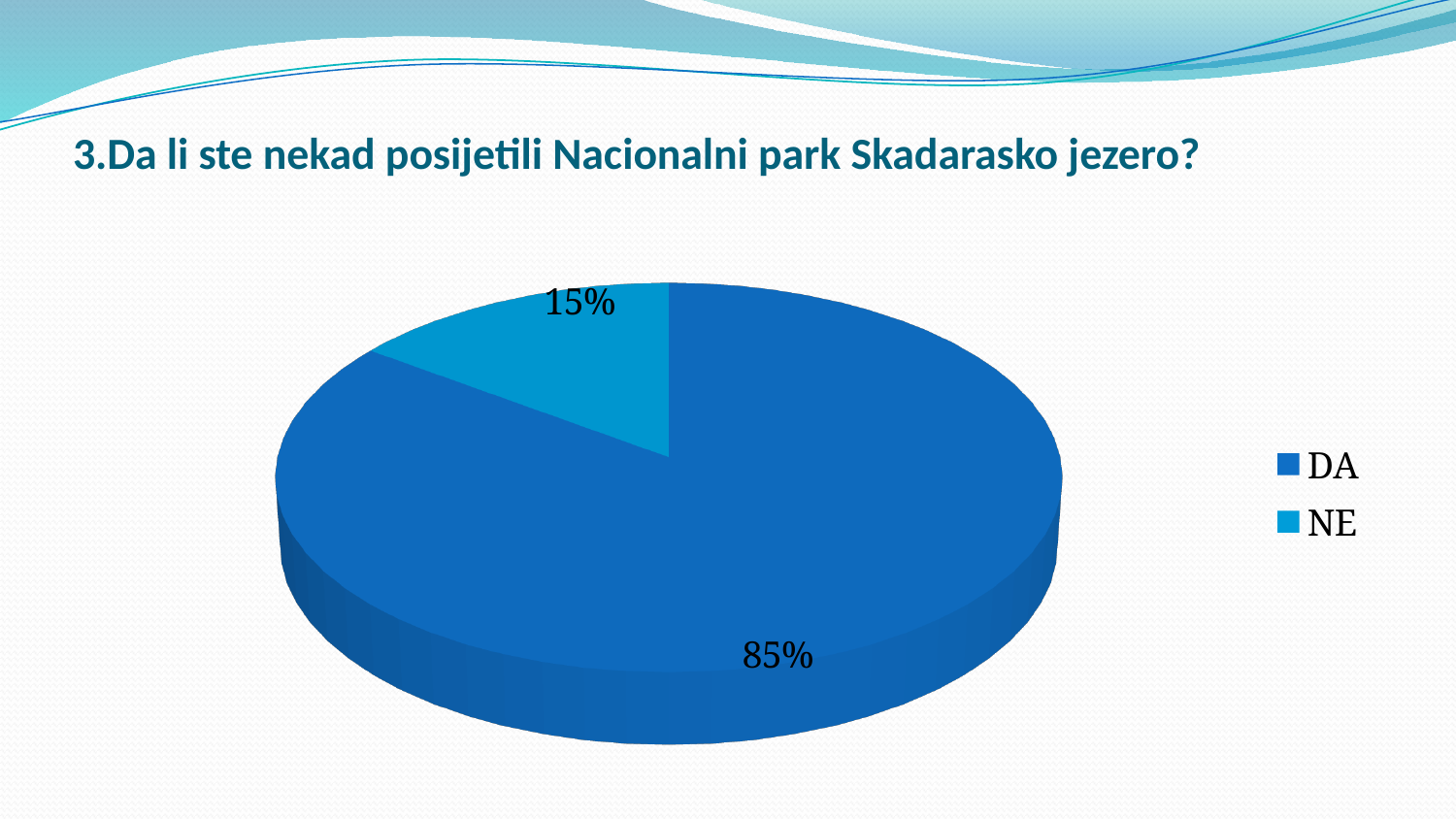
What share of the pie does NE represent? 15% Which category has the largest slice of the pie? DA What kind of chart is shown on the slide? pie chart What share of the pie does DA represent? 85% Which category has the smallest slice of the pie? NE What is the difference in percentage points between the DA and NE slices? 70 Which is larger, the DA slice or the NE slice? DA How many entries does the legend list? 2 Which legend entry is shown in the lighter blue colour? NE What is the title of the slide above the chart? 3.Da li ste nekad posijetili Nacionalni park Skadarasko jezero? How many slices does the pie chart have? 2